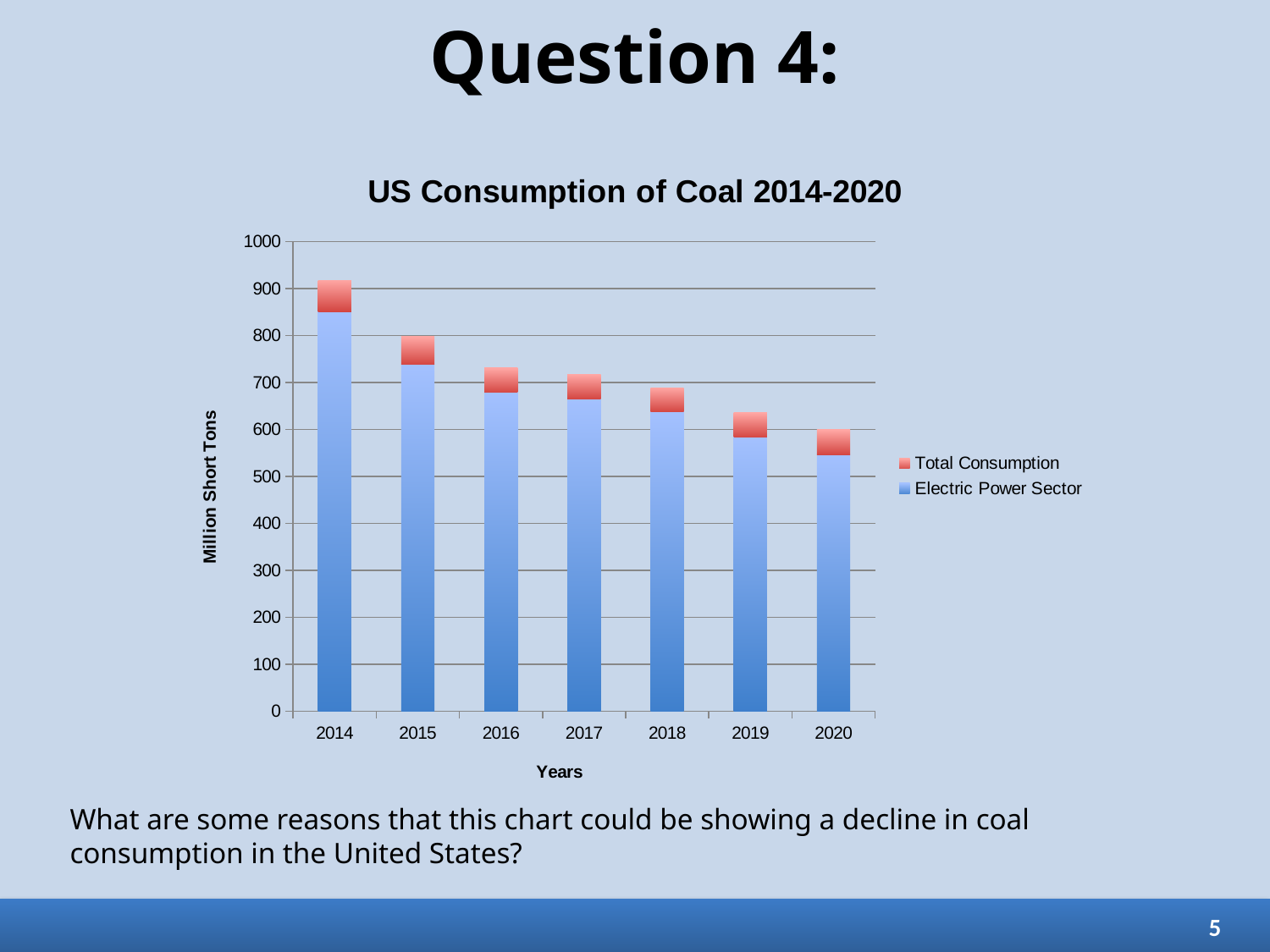
Do the Electric Power Sector values rise or fall from 2014 to 2020? fall Which year has the lowest Electric Power Sector value? 2020 Which is larger, the Electric Power Sector value for 2015 or for 2019? 2015 Is the Electric Power Sector value for 2018 greater or less than 700? less How many series does the legend list? 2 What kind of chart is shown on the slide? bar chart How many years are shown on the x axis? 7 Is the Electric Power Sector value for 2016 greater or less than 600? greater Which year has the highest Electric Power Sector value? 2014 Is the Electric Power Sector value for 2014 greater or less than 800? greater What is the title of the chart? US Consumption of Coal 2014-2020